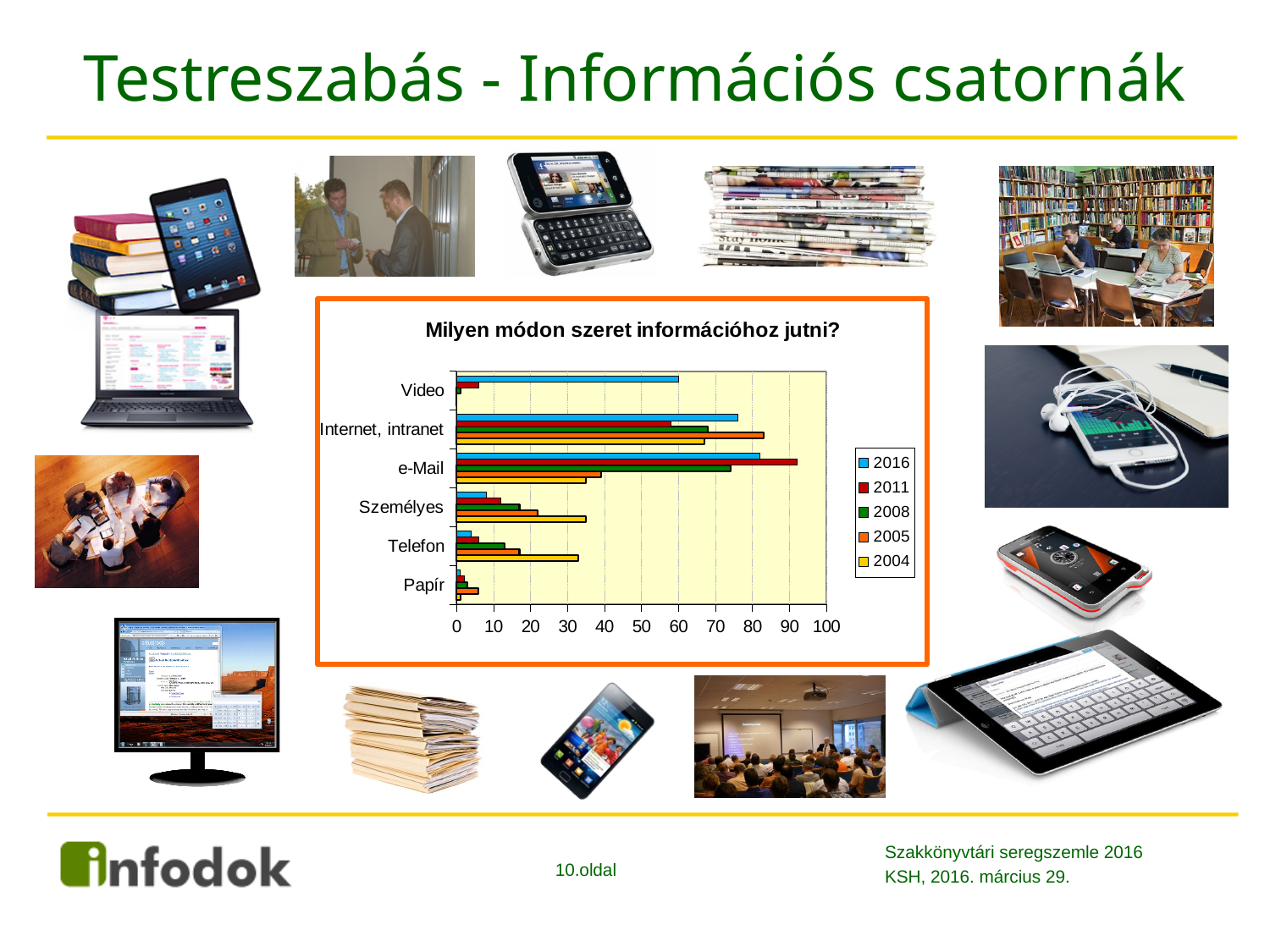
Is the value for e-Mail in 2011 greater or less than 90? greater Is the value for Személyes in 2004 greater or less than 30? greater What kind of chart is shown on the slide? bar chart Which is larger for 2016: the value for Internet, intranet or the value for Video? Internet, intranet How many categories are shown on the chart's vertical axis? 6 Which category has the longest bar for the 2004 series? Internet, intranet What is the title of the chart? Milyen módon szeret információhoz jutni? Which is larger for Személyes: the value for 2004 or the value for 2016? 2004 Which category has the longest bar for the 2016 series? e-Mail Is the value for Video in 2011 greater or less than 10? less Which category has the shortest bar for the 2016 series? Papír How many series does the chart's legend list? 5